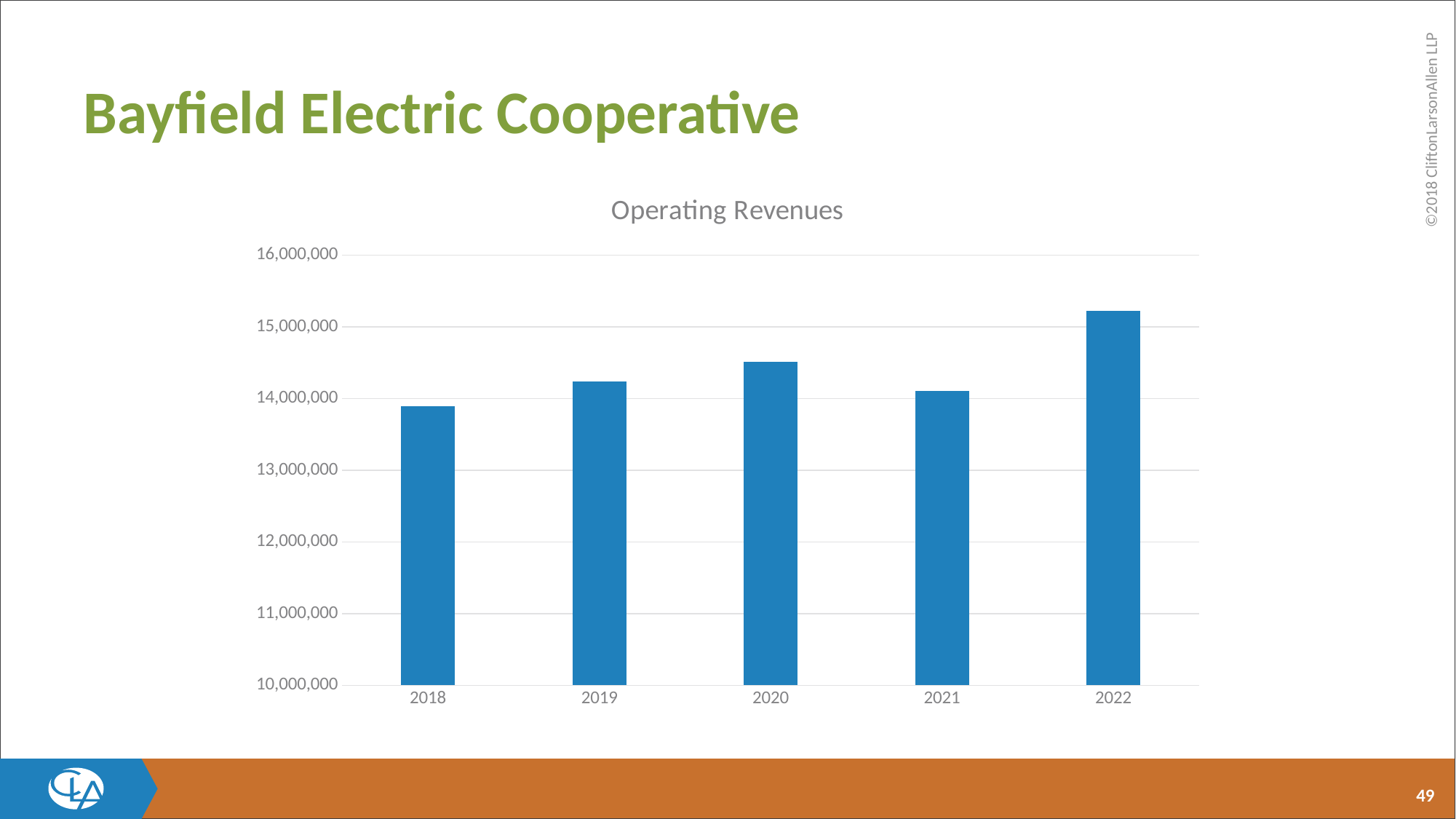
How many years are shown on the x axis of the chart? 5 Is the value for 2018 greater or less than 14,000,000? less Is the value for 2022 greater or less than 15,000,000? greater What type of chart is shown on the slide? Bar chart Which year has higher operating revenues, 2020 or 2021? 2020 Which year has the lowest operating revenues? 2018 Is the value for 2019 greater or less than 15,000,000? less What is the title of the chart? Operating Revenues Do operating revenues rise or fall from 2020 to 2021? fall Which year has the highest operating revenues? 2022 Do operating revenues rise or fall from 2021 to 2022? rise